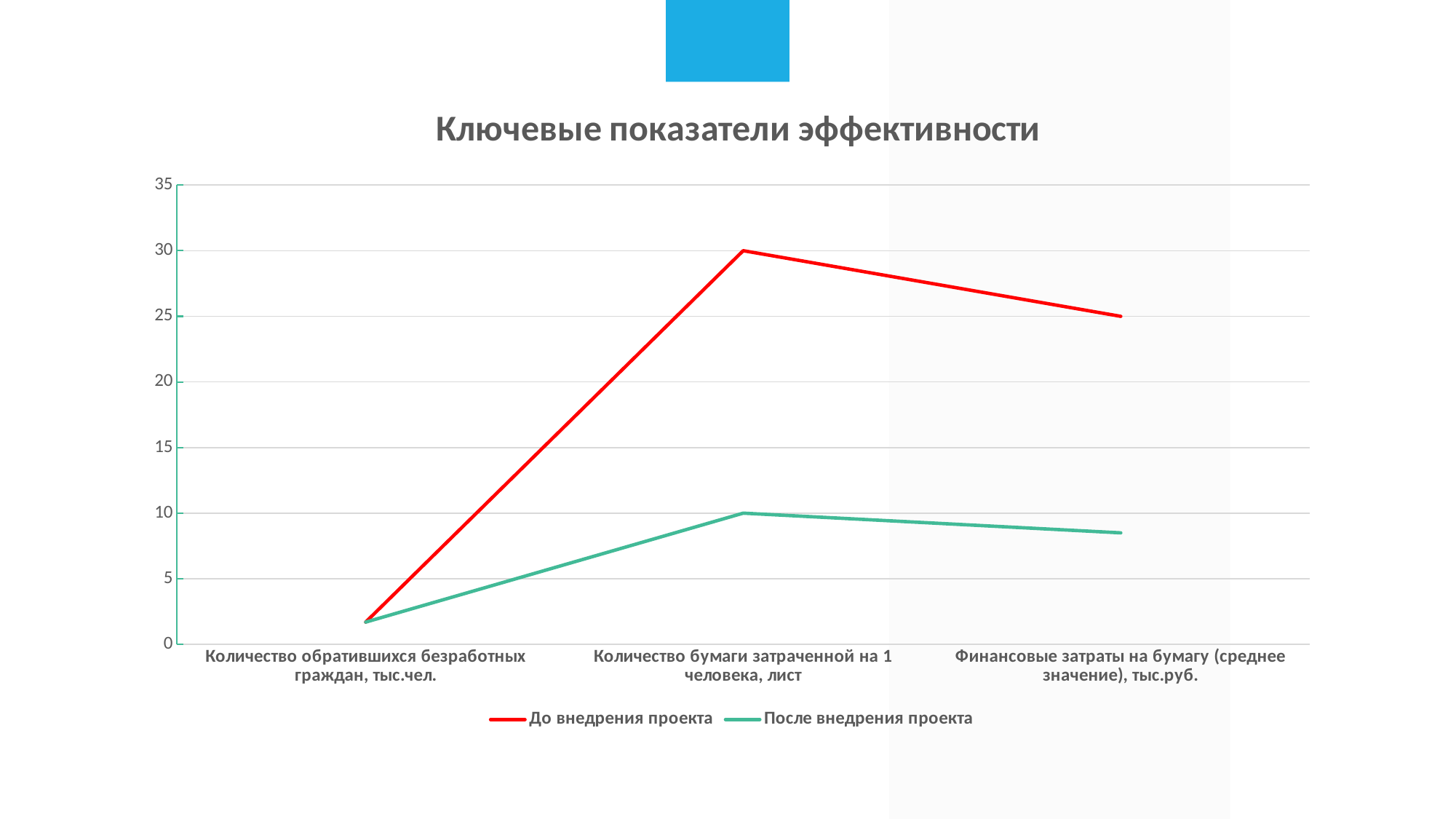
Is the value of 'После внедрения проекта' for 'Финансовые затраты на бумагу (среднее значение), тыс.руб.' greater or less than 10? less What is the value of the 'До внедрения проекта' series for 'Количество бумаги затраченной на 1 человека, лист'? 30 What is the difference between the 'До внедрения проекта' and 'После внедрения проекта' values for 'Количество бумаги затраченной на 1 человека, лист'? 20 How many categories are shown on the x axis? 3 How many series does the legend list? 2 For which category does the 'После внедрения проекта' series have its lowest value? Количество обратившихся безработных граждан, тыс.чел. Which series is higher for 'Финансовые затраты на бумагу (среднее значение), тыс.руб.'? До внедрения проекта What kind of chart is shown on the slide? line chart What is the value of the 'До внедрения проекта' series for 'Финансовые затраты на бумагу (среднее значение), тыс.руб.'? 25 What is the value of the 'После внедрения проекта' series for 'Количество бумаги затраченной на 1 человека, лист'? 10 What is the title of the chart? Ключевые показатели эффективности For which category does the 'До внедрения проекта' series reach its highest value? Количество бумаги затраченной на 1 человека, лист